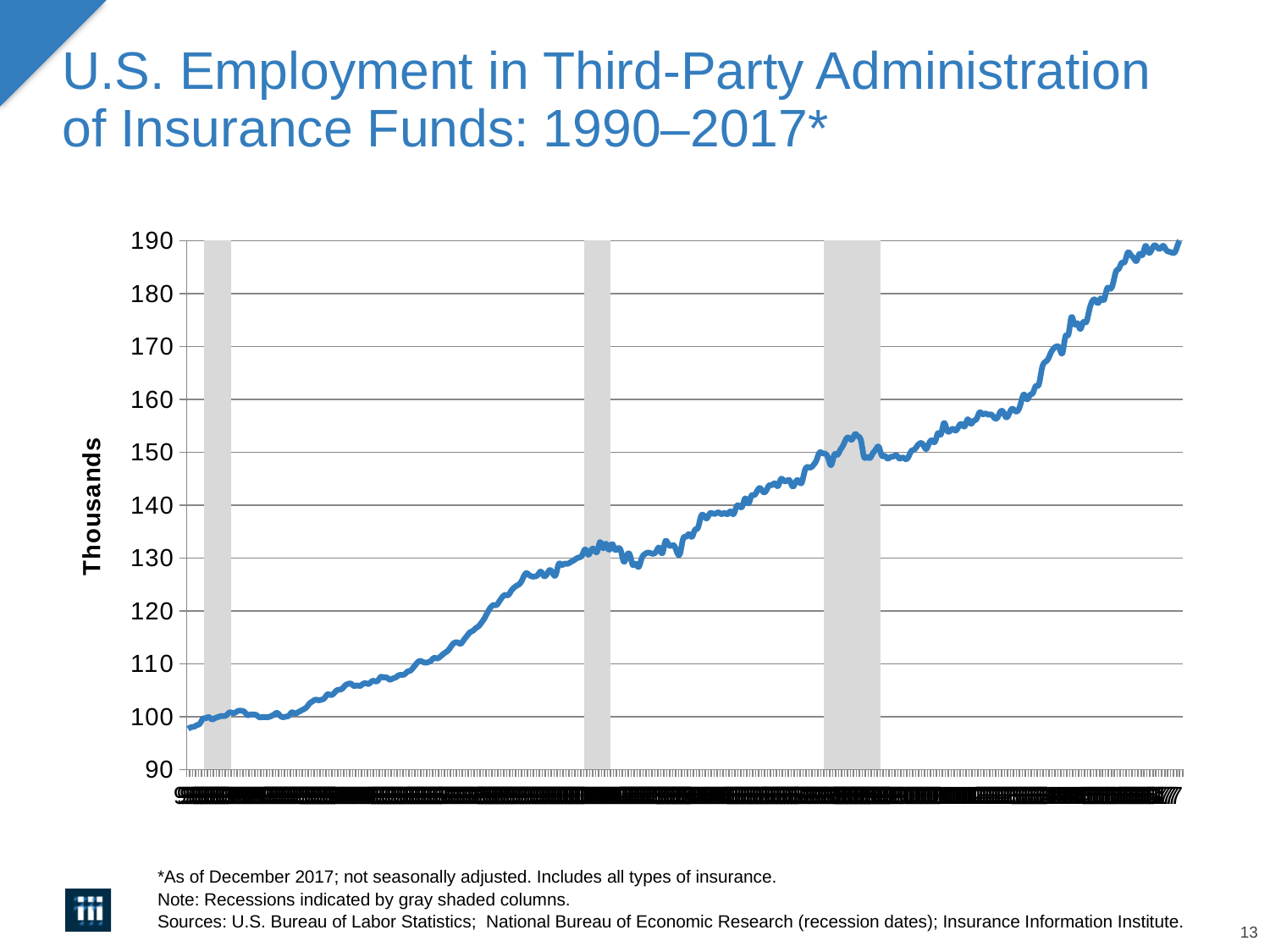
What is the lowest value shown on the vertical axis of the chart? 90 Is the value at the start of the series (1990) greater or less than 110? less Is the value at the end of the series (December 2017) greater or less than 180? greater How many gray shaded recession columns appear on the chart? 3 What is the label on the vertical axis of the chart? Thousands Is the value at the start of the series greater or less than 90? greater Do the values in the chart generally rise or fall from left to right along the x axis? rise What kind of chart is shown on the slide? line chart